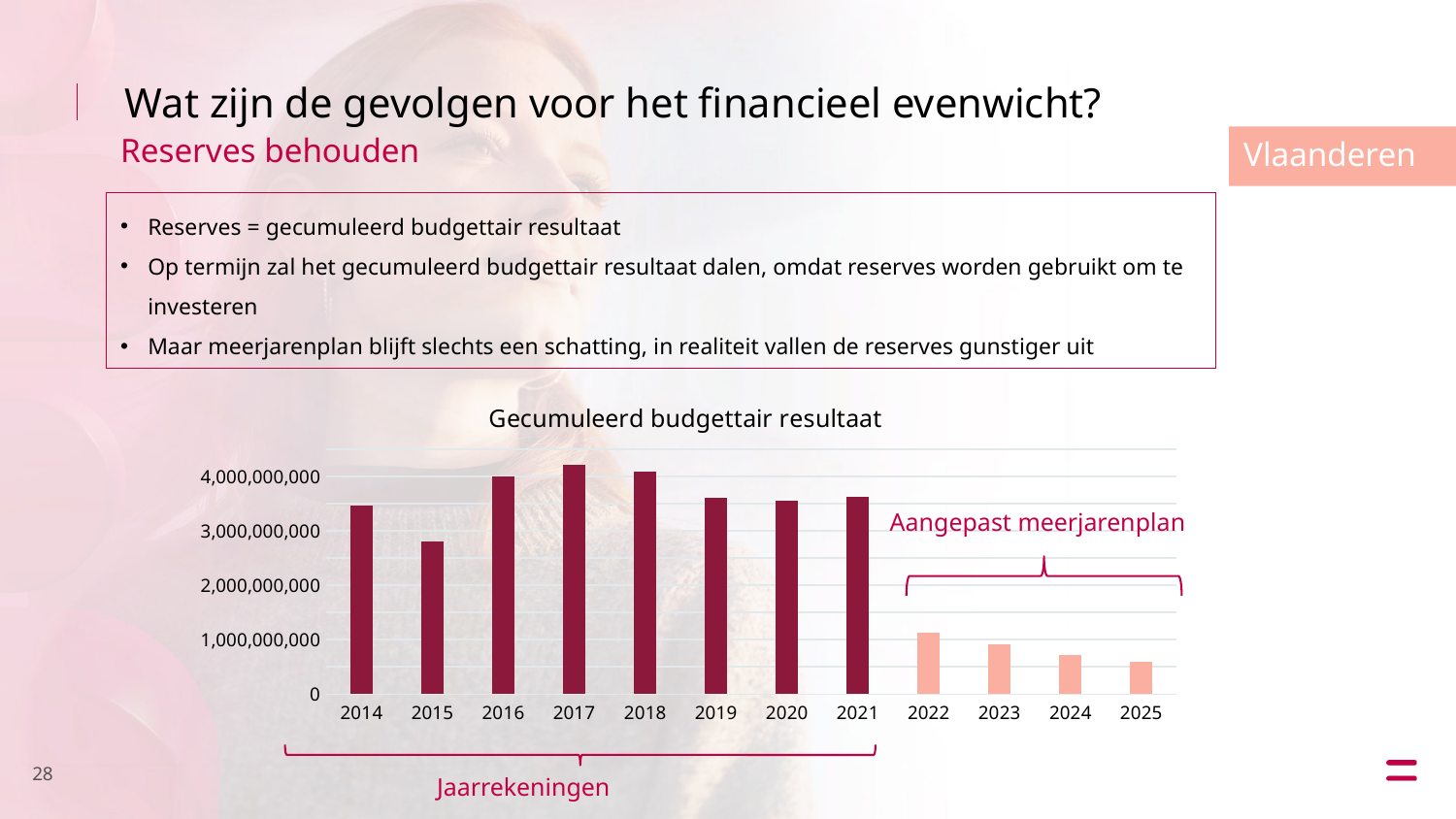
Which year has the highest value in the chart? 2017 Which label is shown under the bracket covering the years 2014 to 2021? Jaarrekeningen Is the value for 2022 greater or less than 1,000,000,000? greater Do the values rise or fall from 2022 to 2025? fall Is the value for 2023 greater or less than 1,000,000,000? less What is the title of the chart? Gecumuleerd budgettair resultaat How many years (bars) are shown on the x axis of the chart? 12 Which year has the lowest value in the chart? 2025 What type of chart is shown on the slide? bar chart Is the value for 2014 greater or less than 3,000,000,000? greater Which year has the larger value, 2014 or 2015? 2014